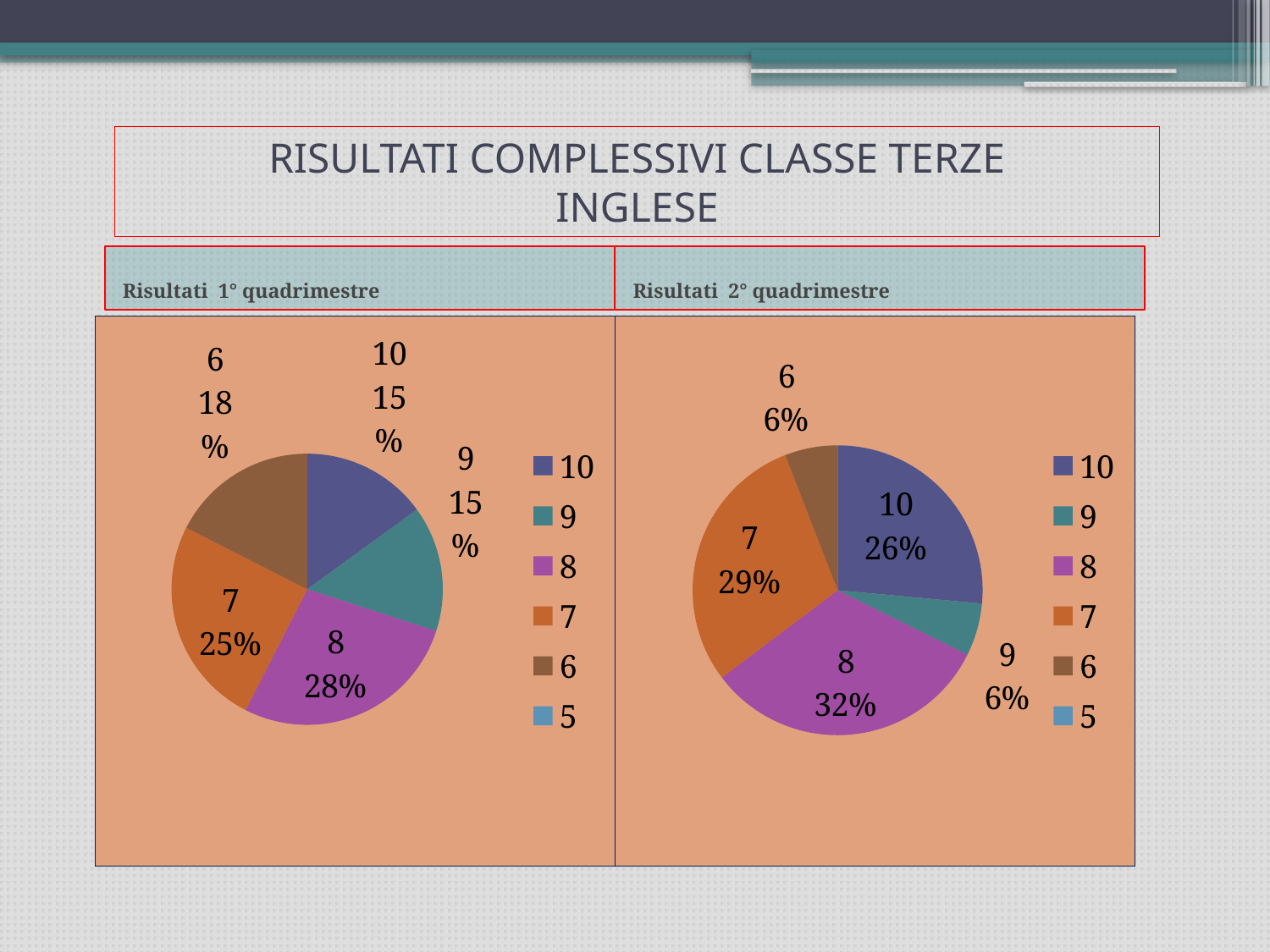
In the 'Risultati 2° quadrimestre' chart, what share does grade 10 have? 26% In the 'Risultati 2° quadrimestre' chart, what is the difference in percentage points between grade 8 and grade 10? 6 In the 'Risultati 2° quadrimestre' chart, which grade has the largest slice? 8 How many entries does the legend of the 'Risultati 1° quadrimestre' chart list? 6 What is the title of the chart on the left of the slide? Risultati 1° quadrimestre In the 'Risultati 1° quadrimestre' chart, what is the difference in percentage points between grade 8 and grade 7? 3 In the 'Risultati 2° quadrimestre' chart, what share does grade 7 have? 29% What kind of chart is 'Risultati 2° quadrimestre'? pie chart In the 'Risultati 2° quadrimestre' chart, which is larger, the share for grade 7 or the share for grade 10? 7 In the 'Risultati 1° quadrimestre' chart, what share does grade 8 have? 28% In the 'Risultati 1° quadrimestre' chart, which grade has the largest slice? 8 In the 'Risultati 1° quadrimestre' chart, what share does grade 6 have? 18%